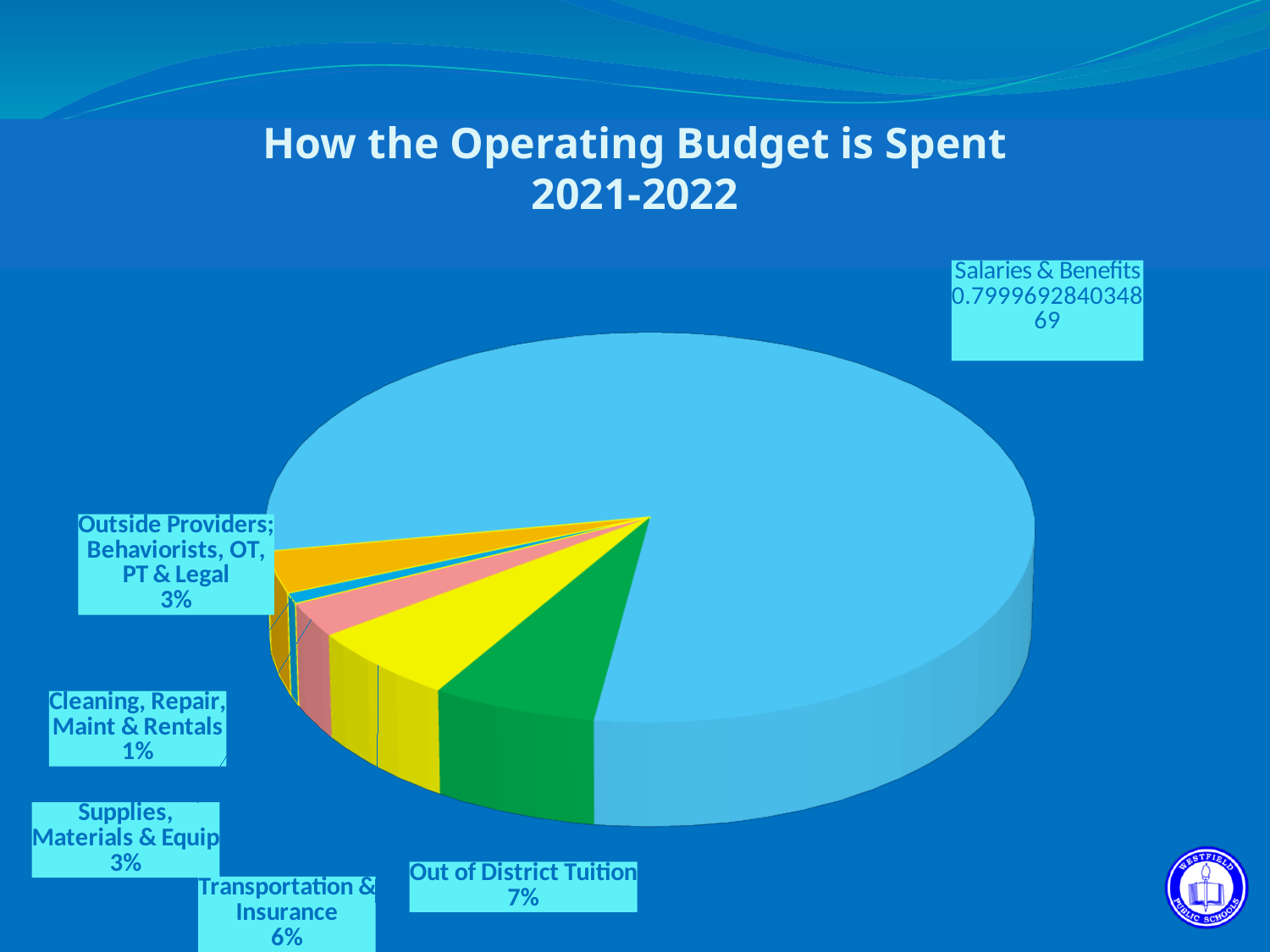
What is the title of the chart? How the Operating Budget is Spent 2021-2022 What share of the operating budget goes to Cleaning, Repair, Maint & Rentals? 1% What share of the operating budget goes to Transportation & Insurance? 6% Which category takes the largest share of the operating budget? Salaries & Benefits What share of the operating budget goes to Outside Providers; Behaviorists, OT, PT & Legal? 3% Which is larger: the share for Out of District Tuition or the share for Transportation & Insurance? Out of District Tuition What kind of chart is shown on the slide? pie chart Which category takes the smallest share of the operating budget? Cleaning, Repair, Maint & Rentals What share of the operating budget goes to Supplies, Materials & Equip? 3% What share of the operating budget goes to Out of District Tuition? 7% What is the difference between the share for Out of District Tuition and the share for Transportation & Insurance? 1% How many categories are shown in the pie chart? 6